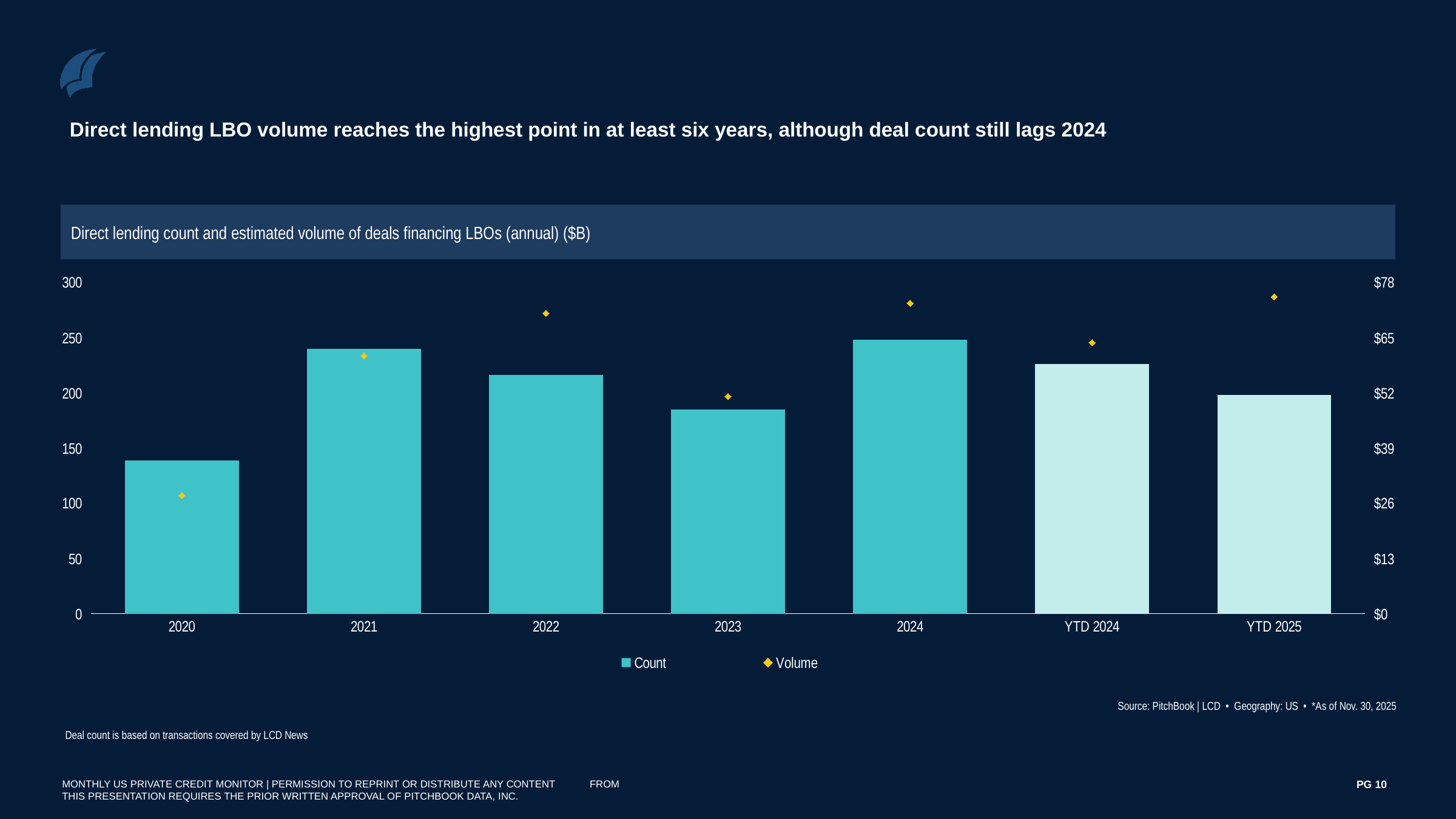
Is the Count for 2021 greater or less than 200? greater Is the Count for 2020 greater or less than 150? less How many categories are shown on the x axis of the chart? 7 What kind of chart is used to plot the Count series? bar chart Which has the larger Volume, 2022 or 2023? 2022 How many series does the chart legend list? 2 Does the Count rise or fall from 2021 to 2023? fall Is the Count for 2023 greater or less than 200? less Which category has the lowest Count? 2020 Which has the larger Count, YTD 2024 or YTD 2025? YTD 2024 Which category has the lowest Volume? 2020